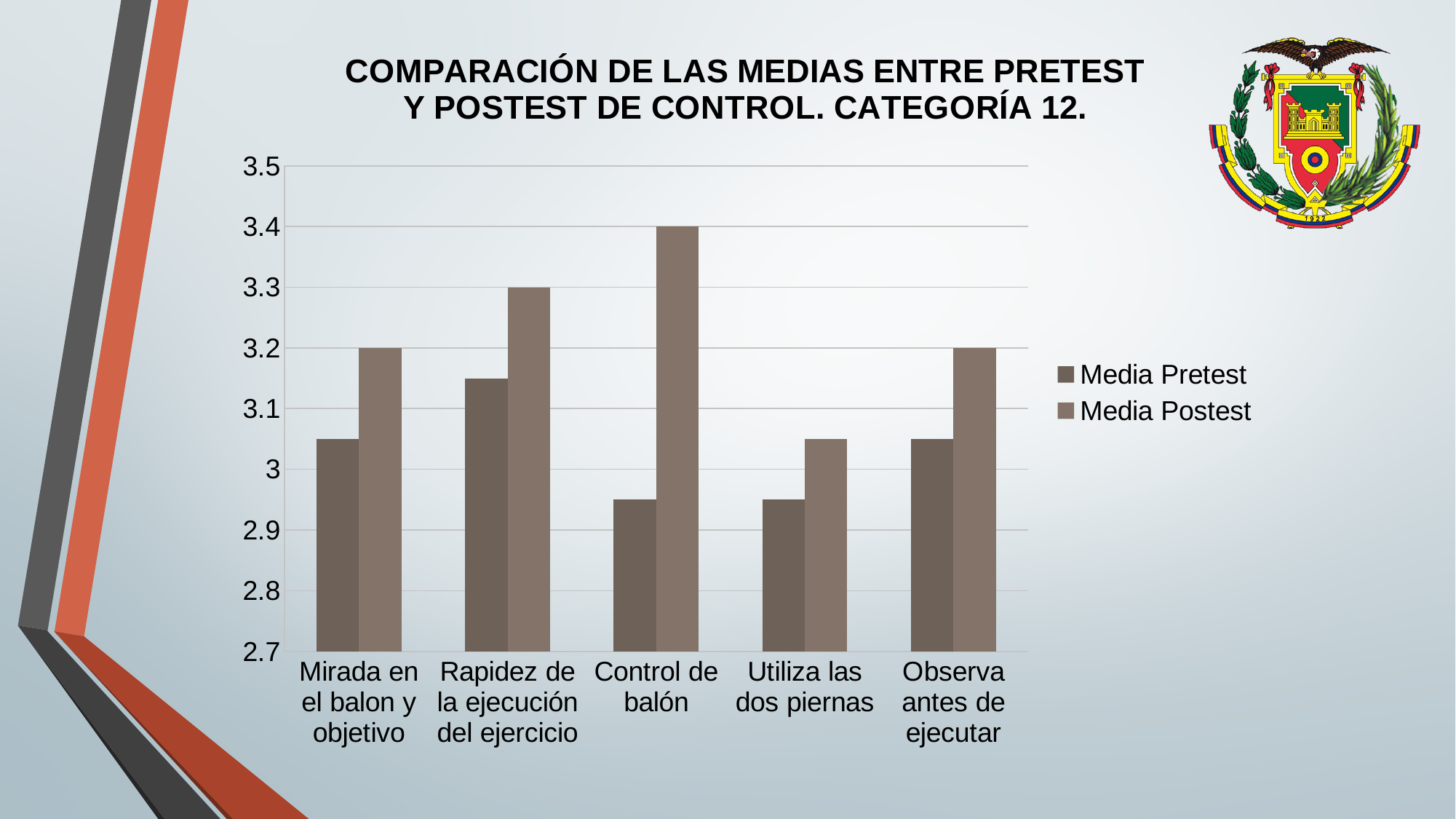
How many categories are shown on the x axis? 5 What is the Media Postest value for Rapidez de la ejecución del ejercicio? 3.3 Which category has the highest Media Postest value? Control de balón What is the Media Postest value for Mirada en el balon y objetivo? 3.2 Which category has the highest Media Pretest value? Rapidez de la ejecución del ejercicio What is the Media Postest value for Control de balón? 3.4 How many series does the legend list? 2 For Observa antes de ejecutar, which is larger, Media Pretest or Media Postest? Media Postest Is the Media Pretest value for Control de balón greater or less than 3? less Is the Media Pretest value for Rapidez de la ejecución del ejercicio greater or less than 3.1? greater Which category has the lowest Media Postest value? Utiliza las dos piernas What type of chart is shown on the slide? bar chart